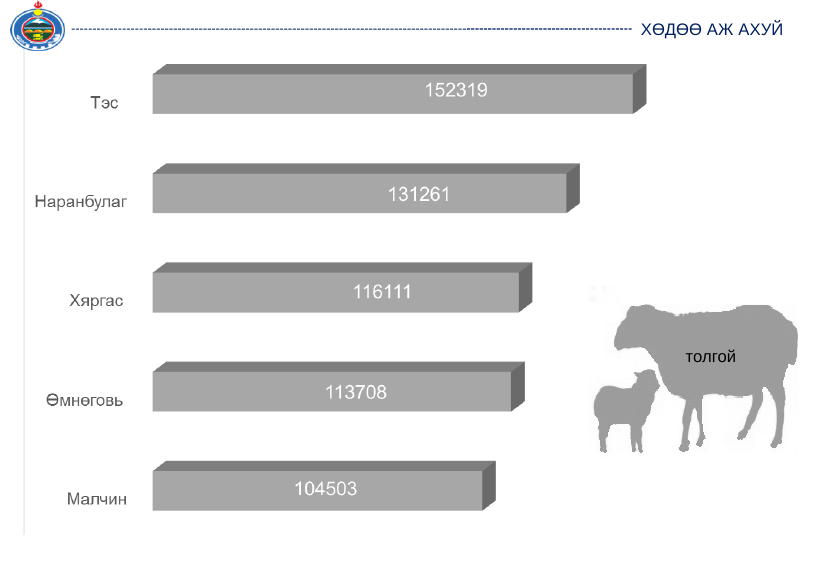
What is the value for Наранбулаг? 131261 What is the value for Малчин? 104503 What is the value for Хяргас? 116111 Which is larger, the value for Наранбулаг or the value for Малчин? Наранбулаг What is the value for Өмнөговь? 113708 Which category has the lowest value? Малчин Which category has the highest value? Тэс How many categories are shown in the chart? 5 What is the difference between the values for Тэс and Наранбулаг? 21058 What is the value for Тэс? 152319 What is the difference between the values for Хяргас and Өмнөговь? 2403 What kind of chart is shown on the slide? Bar chart